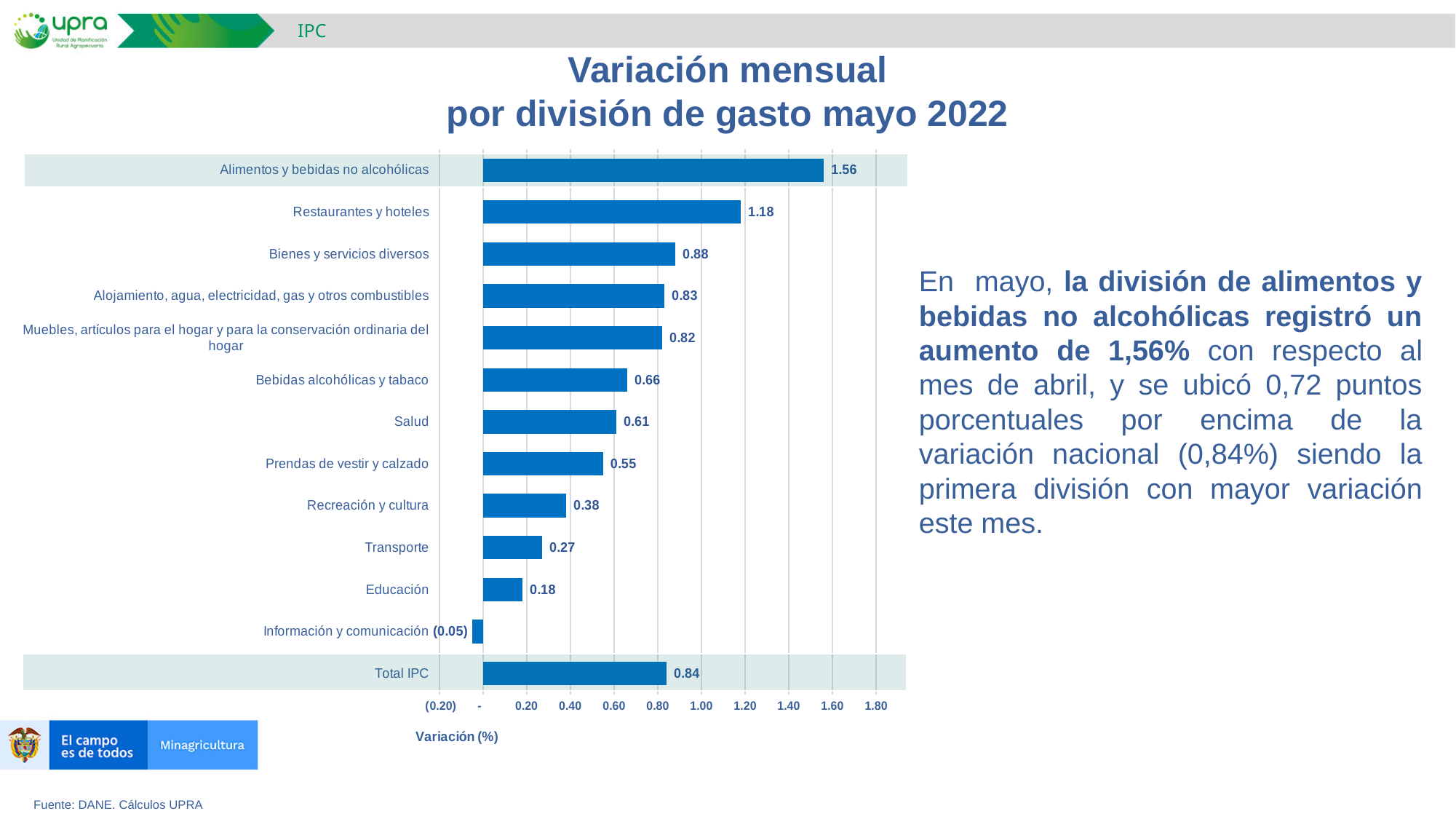
What is the value for Total IPC? 0.84 What is the value for Información y comunicación? (0.05) Which is larger, Salud or Transporte? Salud What is the value for Alimentos y bebidas no alcohólicas? 1.56 How many categories are shown in the chart? 13 Which category has the highest value? Alimentos y bebidas no alcohólicas What is the value for Restaurantes y hoteles? 1.18 What kind of chart is shown? bar chart What is the difference between Alimentos y bebidas no alcohólicas and Total IPC? 0.72 Which category has the lowest value? Información y comunicación Is the value for Bienes y servicios diversos greater or less than 1.00? less What is the label of the horizontal axis? Variación (%)